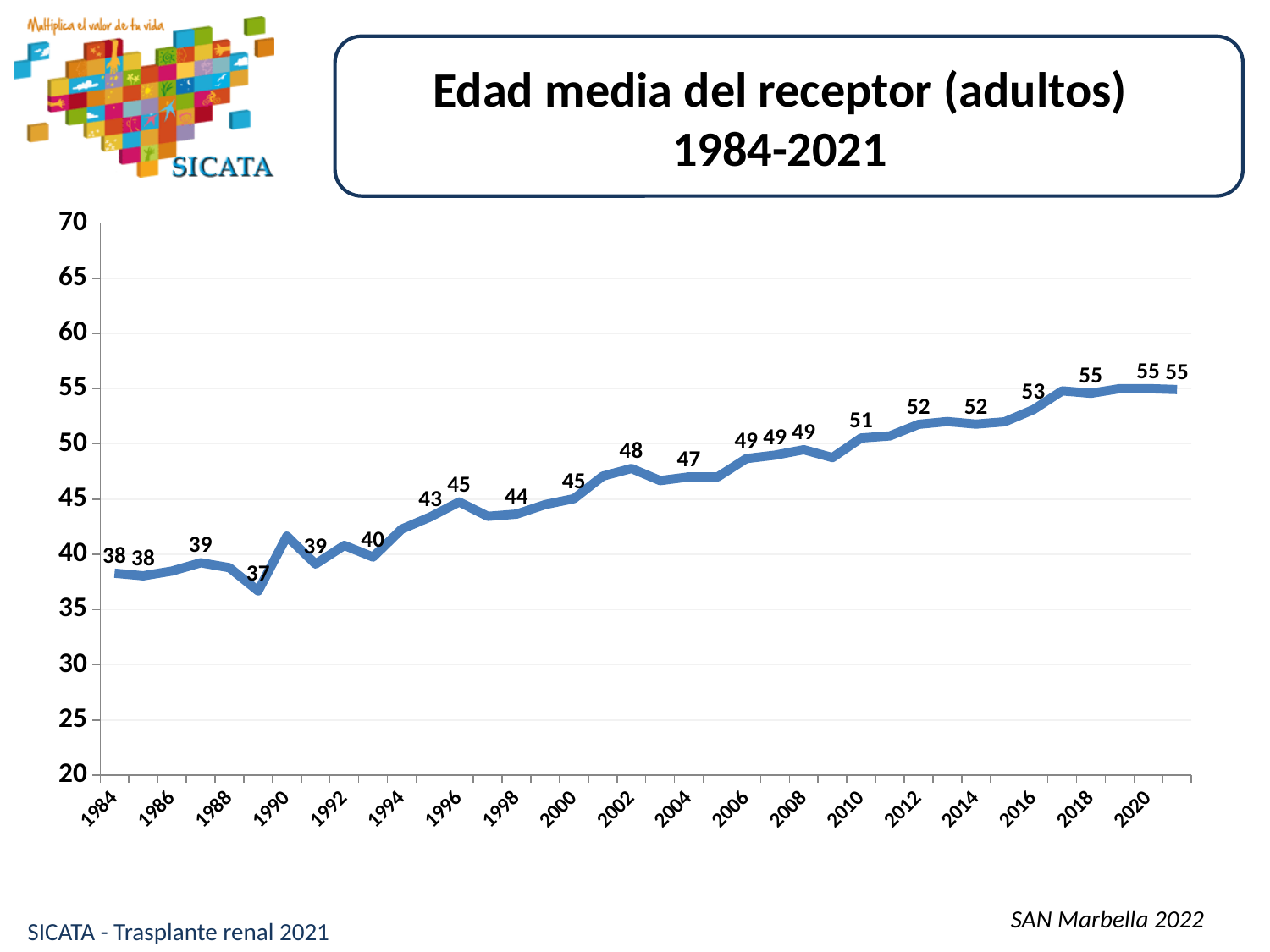
Is the value for 1990 greater or less than 40? greater Which year has the larger value, 2004 or 2010? 2010 What is the difference between the values for 2020 and 1984? 17 What is the lowest value labeled on the chart? 37 What is the highest value labeled on the chart? 55 What is the value labeled for 2002? 48 What is the value labeled for 2020? 55 What is the value labeled for 2010? 51 What kind of chart is shown on the slide? line chart What is the value labeled for 2016? 53 What is the mean recipient age shown for 1984? 38 Overall, do the values rise or fall from 1984 to 2021? rise